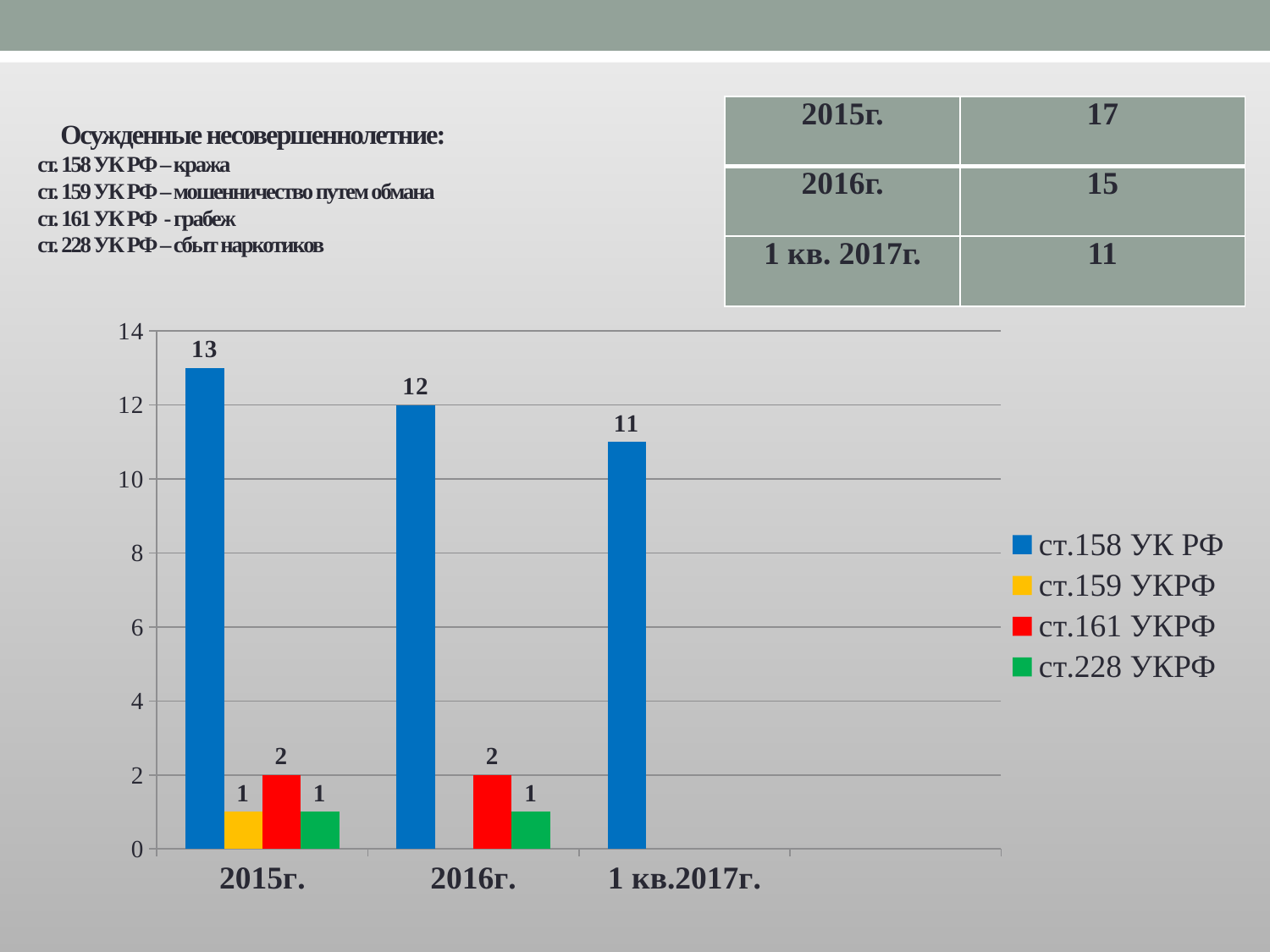
Is the value for ст.158 УК РФ in 2016г. greater or less than 10? greater What kind of chart is shown on the slide? bar chart What is the value for ст.161 УКРФ in 2016г.? 2 What is the value for ст.158 УК РФ in 1 кв.2017г.? 11 What is the value for ст.158 УК РФ in 2015г.? 13 How many categories are shown on the x axis of the chart? 3 In which category does ст.158 УК РФ have its lowest value? 1 кв.2017г. What is the difference between the ст.158 УК РФ values for 2015г. and 1 кв.2017г.? 2 How many series does the chart legend list? 4 In which category does ст.158 УК РФ have its highest value? 2015г. Which is larger in 2015г.: ст.161 УКРФ or ст.228 УКРФ? ст.161 УКРФ What is the value for ст.159 УКРФ in 2015г.? 1